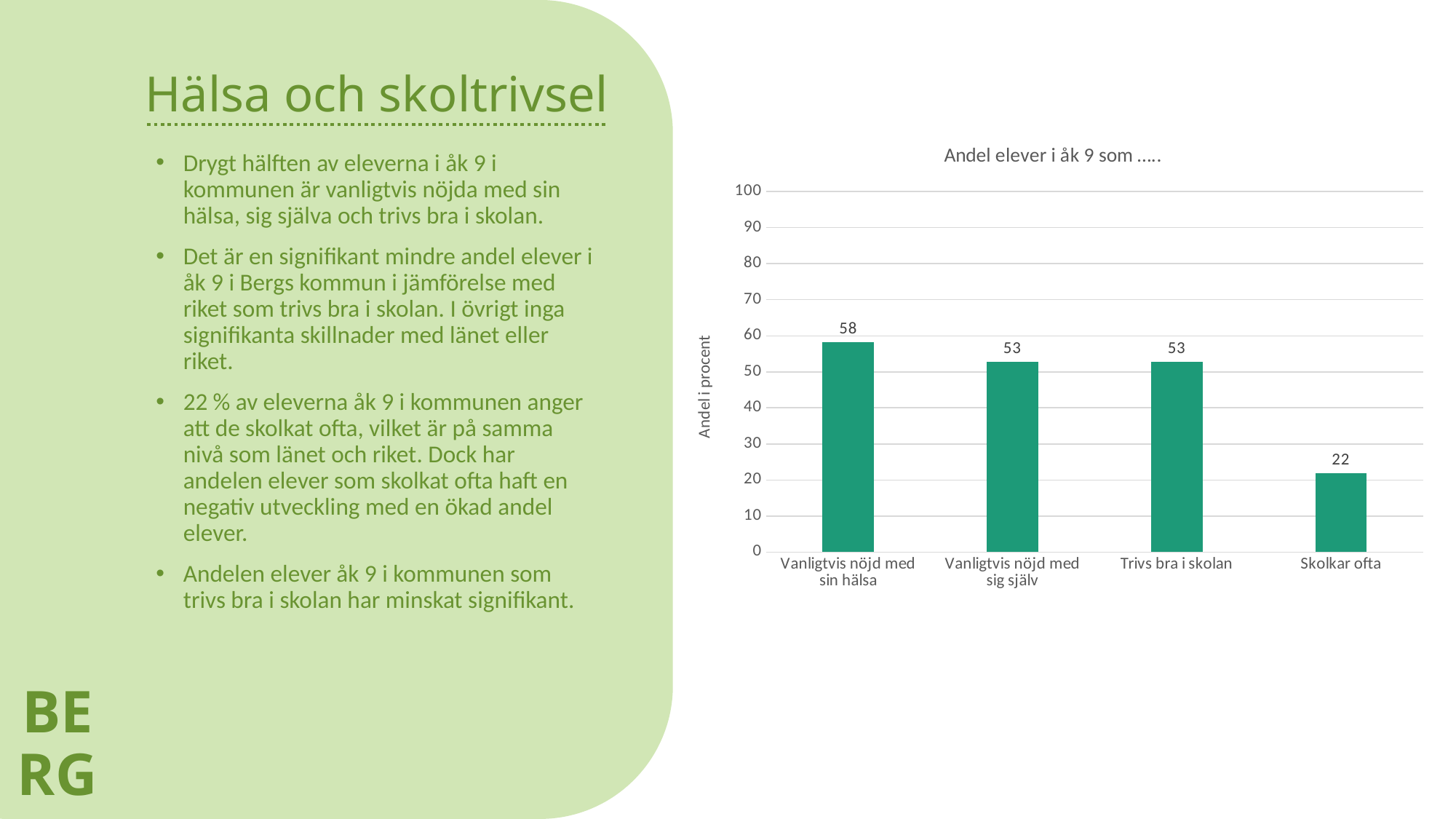
What is the value for "Skolkar ofta"? 22 What is the difference between the values for "Vanligtvis nöjd med sin hälsa" and "Vanligtvis nöjd med sig själv"? 5 How many categories are shown in the chart? 4 What kind of chart is shown on the slide? bar chart Which category has the highest value? Vanligtvis nöjd med sin hälsa What is the difference between the values for "Vanligtvis nöjd med sin hälsa" and "Skolkar ofta"? 36 What is the value for "Vanligtvis nöjd med sin hälsa"? 58 Is the value for "Skolkar ofta" greater or less than 30? less Which category has the lowest value? Skolkar ofta What is the value for "Trivs bra i skolan"? 53 Which is larger, the value for "Trivs bra i skolan" or the value for "Skolkar ofta"? Trivs bra i skolan What is the title of the chart? Andel elever i åk 9 som …..